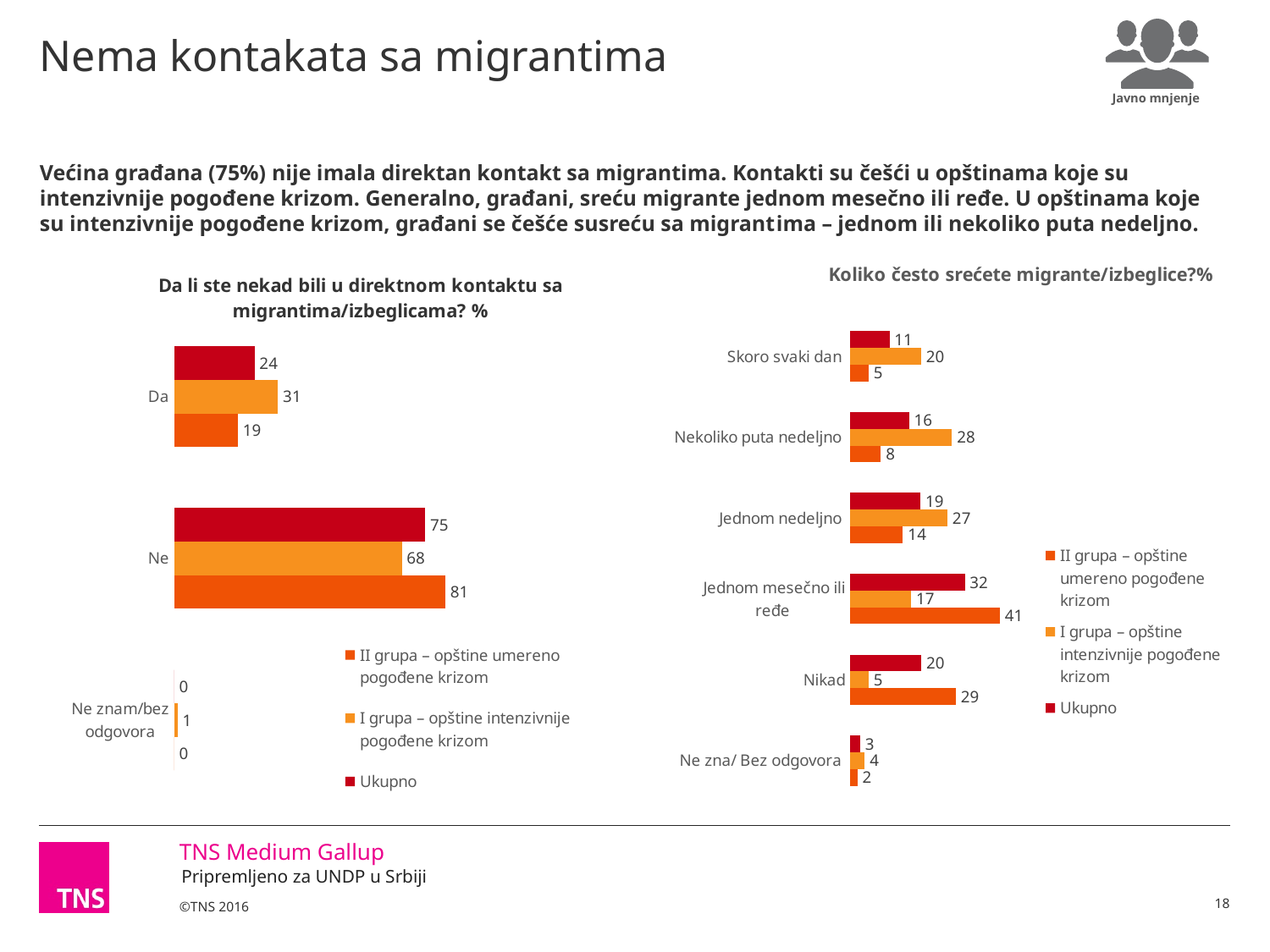
In the chart 'Da li ste nekad bili u direktnom kontaktu sa migrantima/izbeglicama? %', what is the Ukupno value for 'Ne'? 75 How many series does the legend of the chart 'Koliko često srećete migrante/izbeglice?%' list? 3 In the chart 'Koliko često srećete migrante/izbeglice?%', what is the value for 'Nikad' in the 'II grupa – opštine umereno pogođene krizom' series? 29 In the chart 'Da li ste nekad bili u direktnom kontaktu sa migrantima/izbeglicama? %', what is the value for 'Da' in the 'I grupa – opštine intenzivnije pogođene krizom' series? 31 In the chart 'Da li ste nekad bili u direktnom kontaktu sa migrantima/izbeglicama? %', what is the difference between the 'II grupa' and 'I grupa' values for 'Ne'? 13 In the chart 'Da li ste nekad bili u direktnom kontaktu sa migrantima/izbeglicama? %', how many categories are shown? 3 What type of chart is 'Da li ste nekad bili u direktnom kontaktu sa migrantima/izbeglicama? %'? Bar chart In the chart 'Koliko često srećete migrante/izbeglice?%', which is larger for 'Nekoliko puta nedeljno': the I grupa value or the II grupa value? I grupa In the chart 'Koliko često srećete migrante/izbeglice?%', which category has the lowest value in the 'I grupa – opštine intenzivnije pogođene krizom' series? Ne zna/ Bez odgovora In the chart 'Koliko često srećete migrante/izbeglice?%', what is the Ukupno value for 'Jednom mesečno ili ređe'? 32 In the chart 'Koliko često srećete migrante/izbeglice?%', what is the difference between the II grupa and I grupa values for 'Jednom mesečno ili ređe'? 24 In the chart 'Koliko često srećete migrante/izbeglice?%', which category has the highest Ukupno value? Jednom mesečno ili ređe